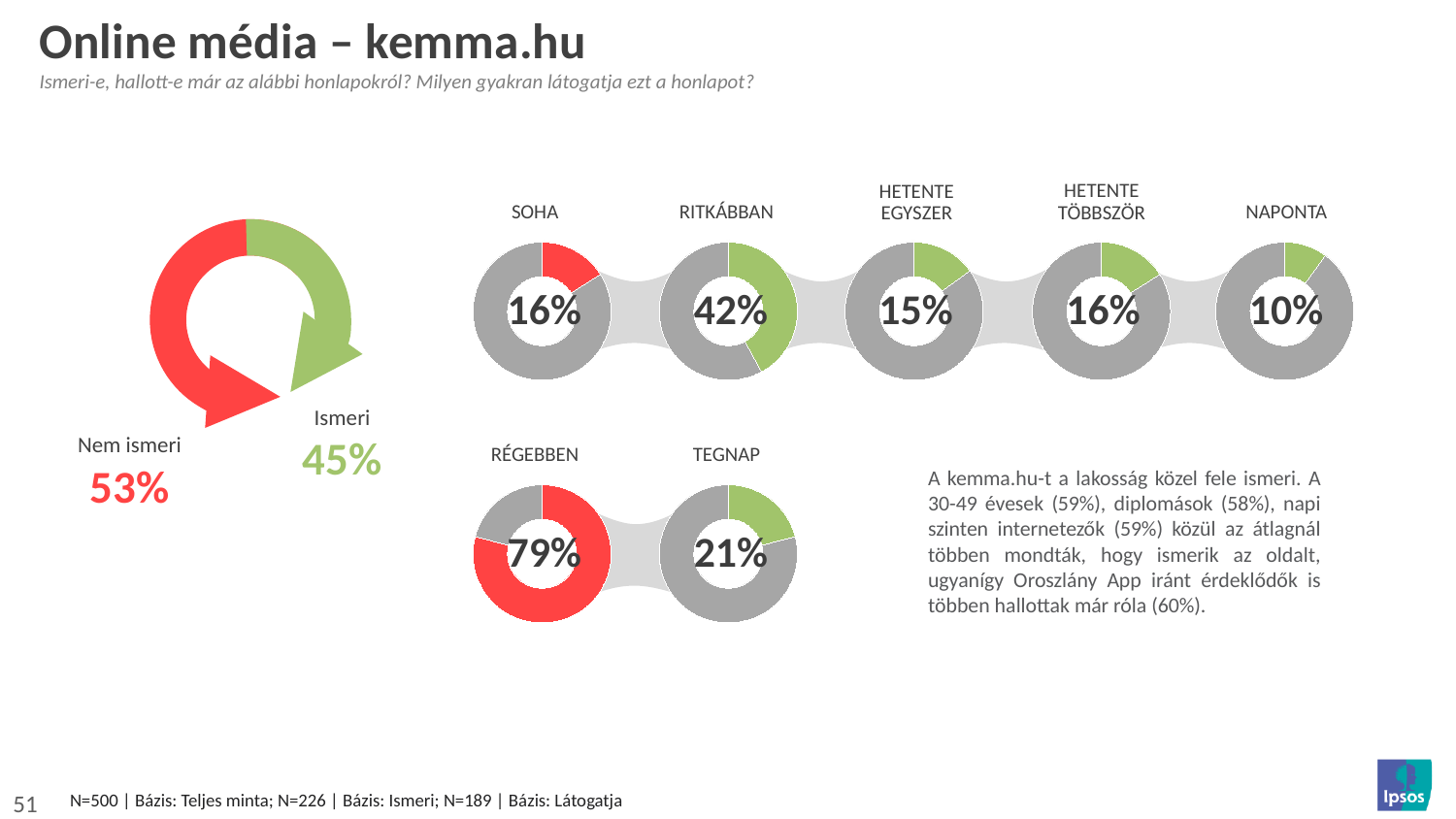
In the large donut chart on the left, what percentage is shown for "Nem ismeri"? 53% In the pair of donut charts at the bottom, what value is shown for "RÉGEBBEN"? 79% In the large donut chart on the left, what is the difference between "Nem ismeri" and "Ismeri"? 8 percentage points In the row of five small donut charts at the top, which category has the lowest value? NAPONTA In the pair of donut charts at the bottom, which is larger, "RÉGEBBEN" or "TEGNAP"? RÉGEBBEN In the row of five small donut charts at the top, what value is shown for "RITKÁBBAN"? 42% In the large donut chart on the left, what percentage is shown for "Ismeri"? 45% How many small donut charts are in the top row of frequency categories? 5 In the row of five small donut charts at the top, what value is shown for "NAPONTA"? 10% In the large donut chart on the left, which is larger, "Nem ismeri" or "Ismeri"? Nem ismeri In the row of five small donut charts at the top, which category has the highest value? RITKÁBBAN In the row of five small donut charts at the top, what is the difference between "RITKÁBBAN" and "SOHA"? 26 percentage points